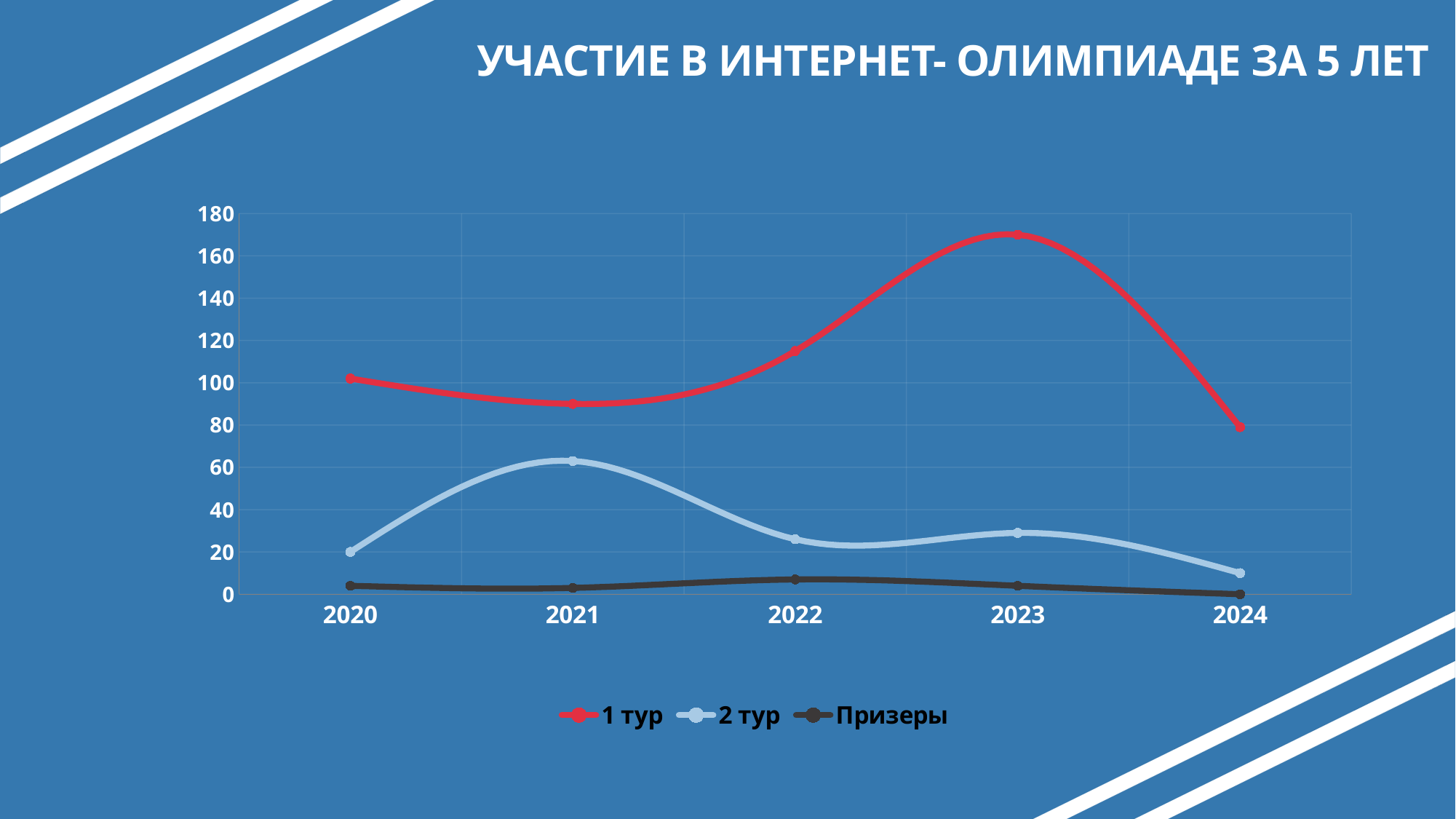
How many series does the legend list? 3 How many years are plotted along the x axis? 5 Does the series "1 тур" rise or fall from 2023 to 2024? fall In which year does the series "1 тур" have its lowest value? 2024 Is the value for "1 тур" in 2024 greater or less than 100? less Which is larger for "2 тур": the value in 2021 or the value in 2022? 2021 What kind of chart is shown on the slide? line chart Is the value for "1 тур" in 2023 greater or less than 160? greater What is the title of the chart? УЧАСТИЕ В ИНТЕРНЕТ- ОЛИМПИАДЕ ЗА 5 ЛЕТ In which year does the series "2 тур" reach its highest value? 2021 In which year does the series "2 тур" have its lowest value? 2024 In which year does the series "1 тур" reach its highest value? 2023